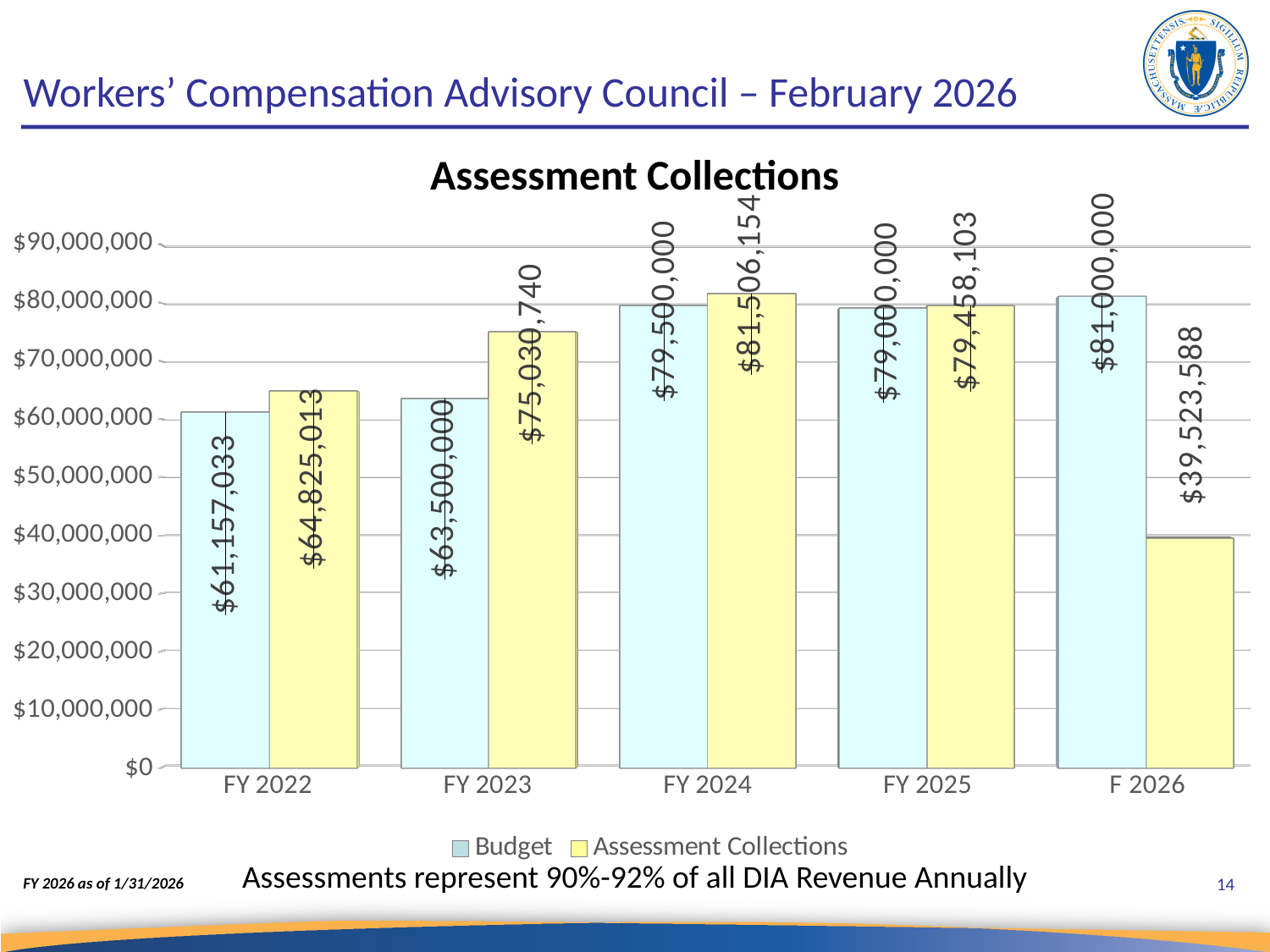
Which fiscal year has the lowest Budget value? FY 2022 For FY 2023, which is larger: the Budget or the Assessment Collections? Assessment Collections What is the difference between Assessment Collections and Budget for FY 2023? $11,530,740 What is the Budget value for FY 2025? $79,000,000 What is the Budget value for FY 2022? $61,157,033 Do the Assessment Collections values rise or fall from FY 2022 to FY 2024? rise What is the Assessment Collections value for FY 2023? $75,030,740 What is the Assessment Collections value for F 2026? $39,523,588 How many series does the legend list? 2 How many fiscal years are shown on the x axis? 5 Is the Budget value for FY 2022 greater or less than $60,000,000? greater Which fiscal year has the highest Assessment Collections value? FY 2024